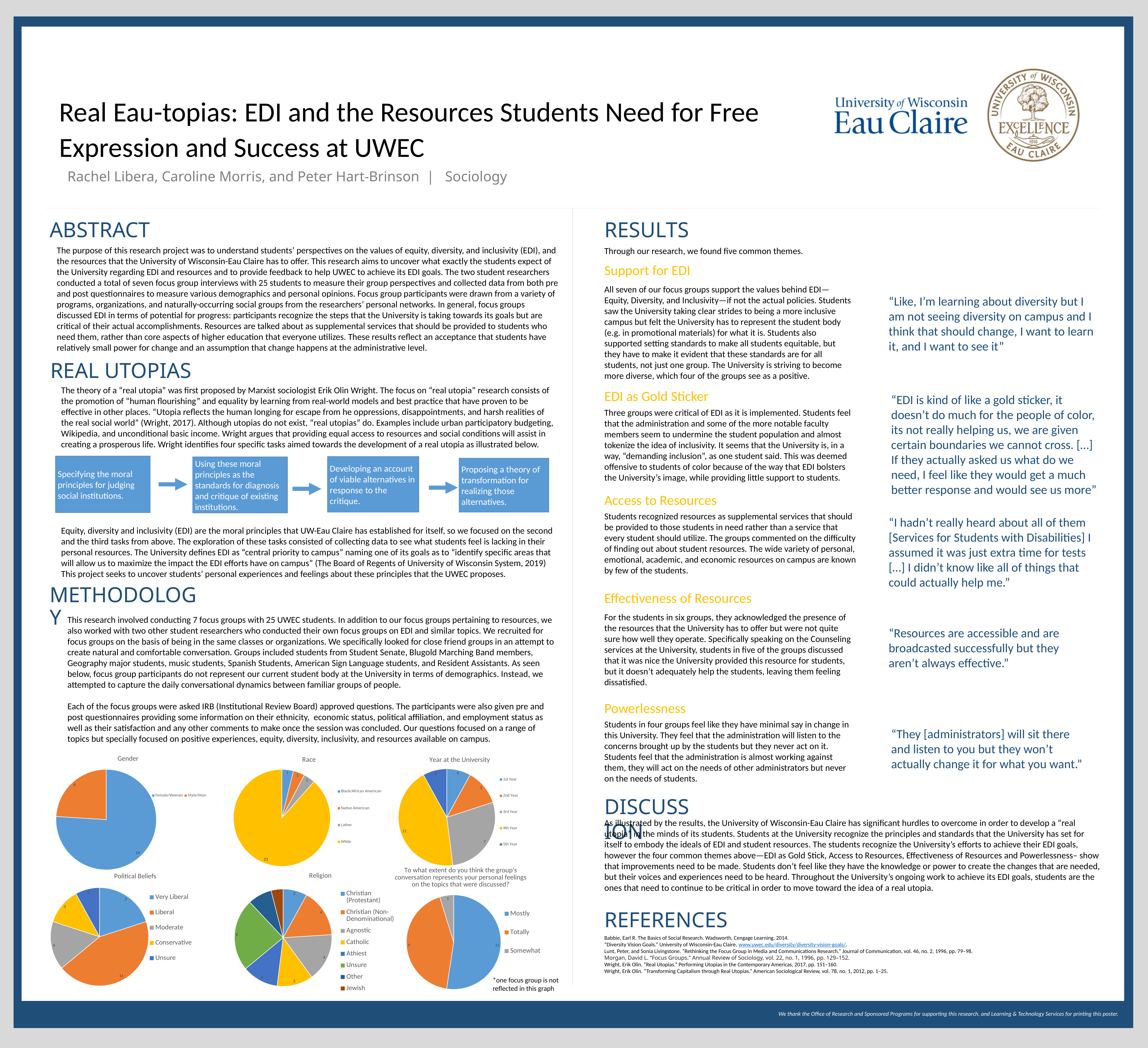
In the Race chart, what is the value for White? 23 In the Gender chart, how many participants are labelled Female/Woman? 19 In the Gender chart, how many participants are labelled Male/Man? 6 In the Gender chart, what is the difference between the Female/Woman and Male/Man counts? 13 In the chart titled 'To what extent do you think the group's conversation represents your personal feelings on the topics that were discussed?', what is the value for Totally? 9 In the Religion chart, which category has the largest slice? Unsure In the Year at the University chart, which year has the largest slice? 4th Year In the Year at the University chart, what is the value for 3rd Year? 7 In the Race chart, how many categories does the legend list? 4 In the Political Beliefs chart, what is the value for Moderate? 4 In the Religion chart, how many categories does the legend list? 8 In the Political Beliefs chart, which category has the highest value? Liberal